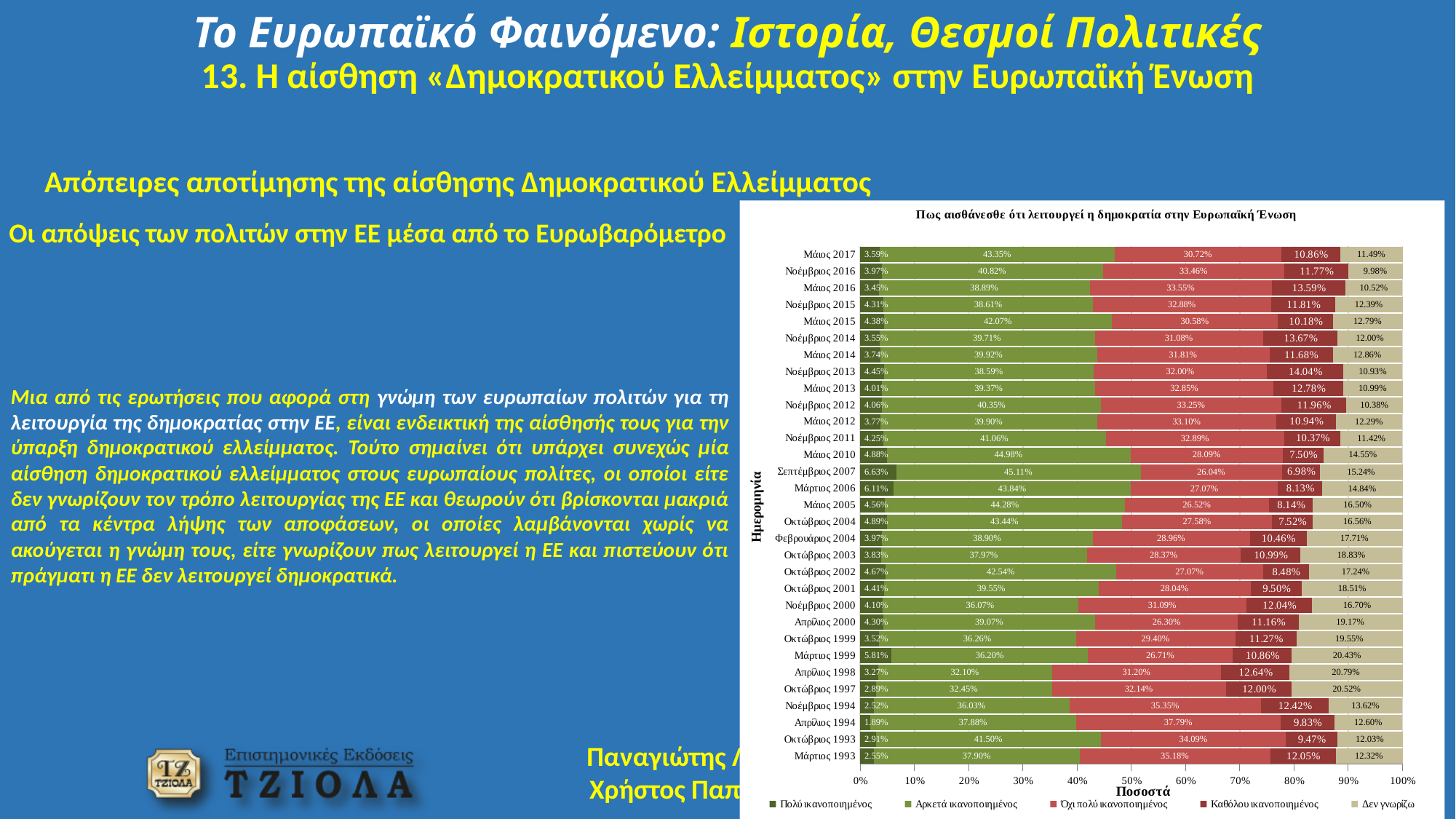
How many dates (categories) are plotted on the chart? 31 Which date has the lowest value for 'Πολύ ικανοποιημένος'? Απρίλιος 1994 How many series does the legend of the chart list? 5 Which date has the highest value for 'Δεν γνωρίζω'? Απρίλιος 1998 What is the value of 'Αρκετά ικανοποιημένος' for Μάιος 2017? 43.35% What is the title of the chart? Πως αισθάνεσθε ότι λειτουργεί η δημοκρατία στην Ευρωπαϊκή Ένωση Which date has the highest value for 'Πολύ ικανοποιημένος'? Σεπτέμβριος 2007 What is the value of 'Καθόλου ικανοποιημένος' for Νοέμβριος 2013? 14.04% What is the value of 'Δεν γνωρίζω' for Μάρτιος 1999? 20.43% Which has the larger 'Αρκετά ικανοποιημένος' value, Μάιος 2015 or Μάιος 2016? Μάιος 2015 What is the difference between the 'Όχι πολύ ικανοποιημένος' values for Νοέμβριος 2016 and Μάιος 2017? 2.74% What type of chart is shown on the slide? Stacked bar chart